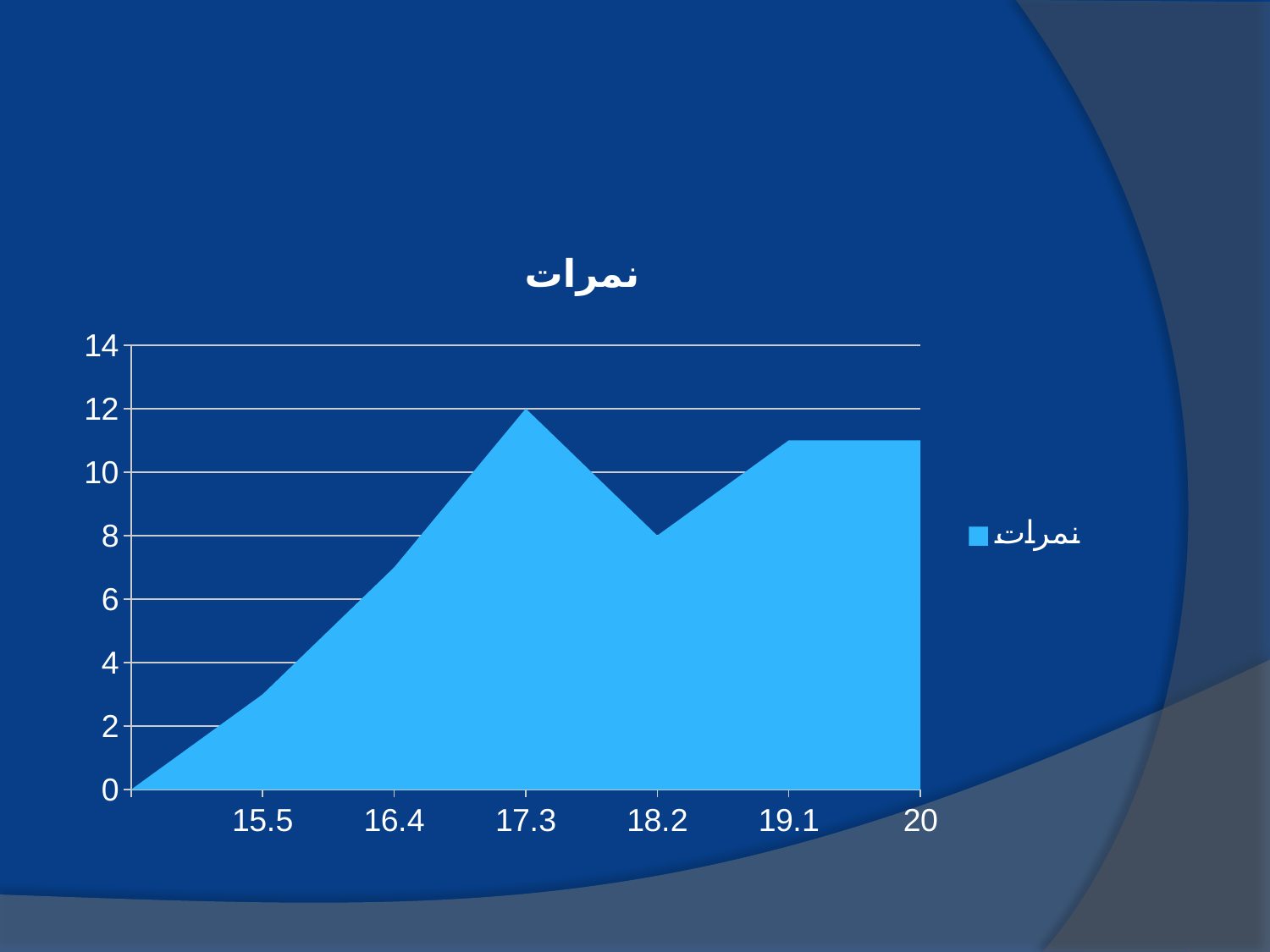
Is the value at 15.5 greater or less than 4? less Which labeled x-axis category has the highest value? 17.3 Does the value rise or fall from 17.3 to 18.2? fall Is the value at 16.4 greater or less than 6? greater Is the value at 19.1 greater or less than 10? greater What is the value at 18.2? 8 What kind of chart is shown on the slide? area chart How many series does the legend list? 1 What is the title of the chart? نمرات Which has the larger value, 17.3 or 18.2? 17.3 What is the difference between the values at 17.3 and 18.2? 4 What is the value at 17.3? 12